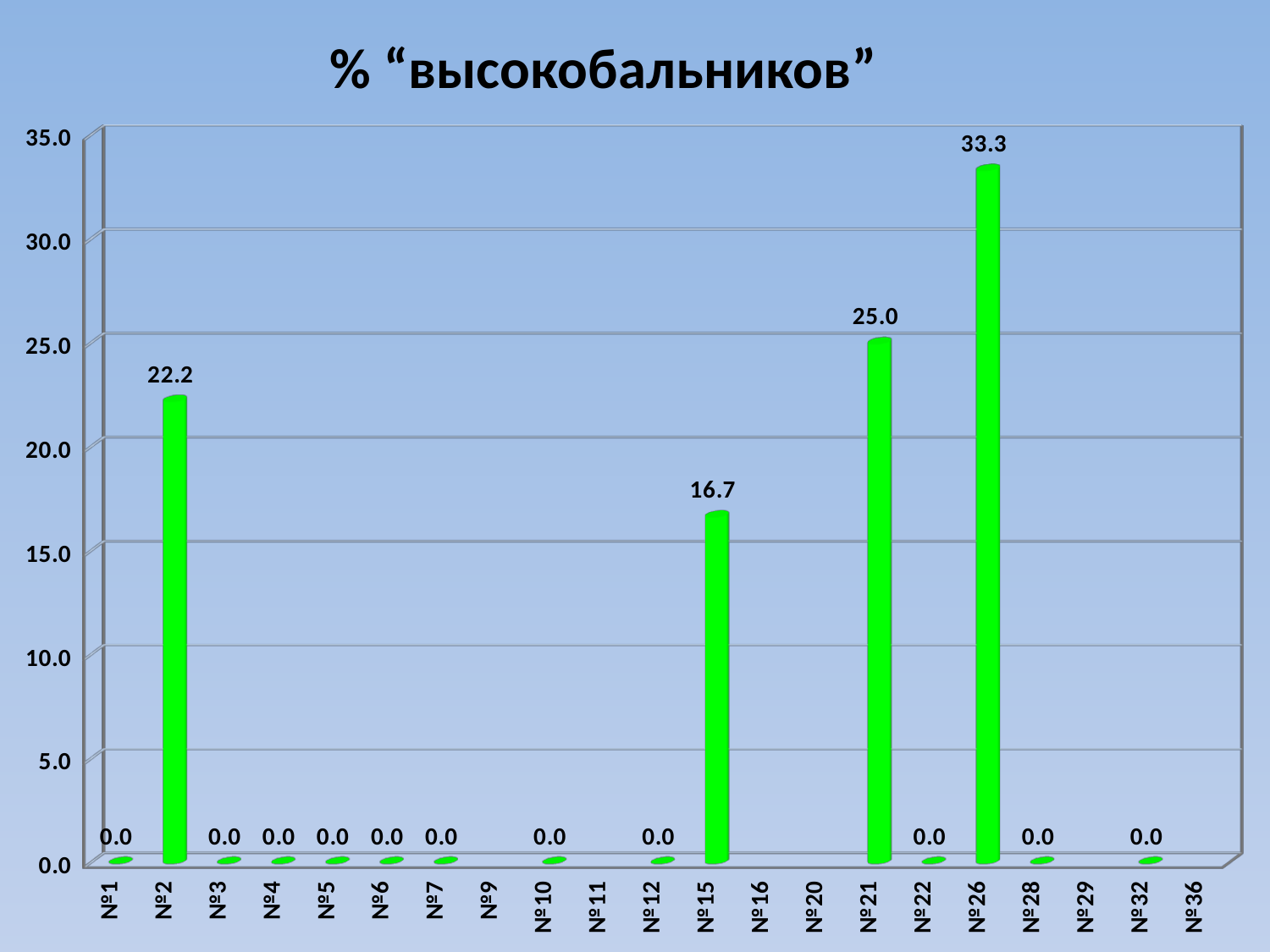
What is the title of the chart? % "высокобальников" What is the difference between the values for №26 and №21? 8.3 What kind of chart is shown on the slide? bar chart What is the difference between the values for №2 and №15? 5.5 Which is larger, the value for №2 or the value for №21? №21 How many categories are shown on the x axis? 21 Which category has the highest value? №26 What is the value for №2? 22.2 What is the value for №21? 25.0 What is the value for №15? 16.7 Is the value for №26 greater or less than 30.0? greater What is the value for №26? 33.3